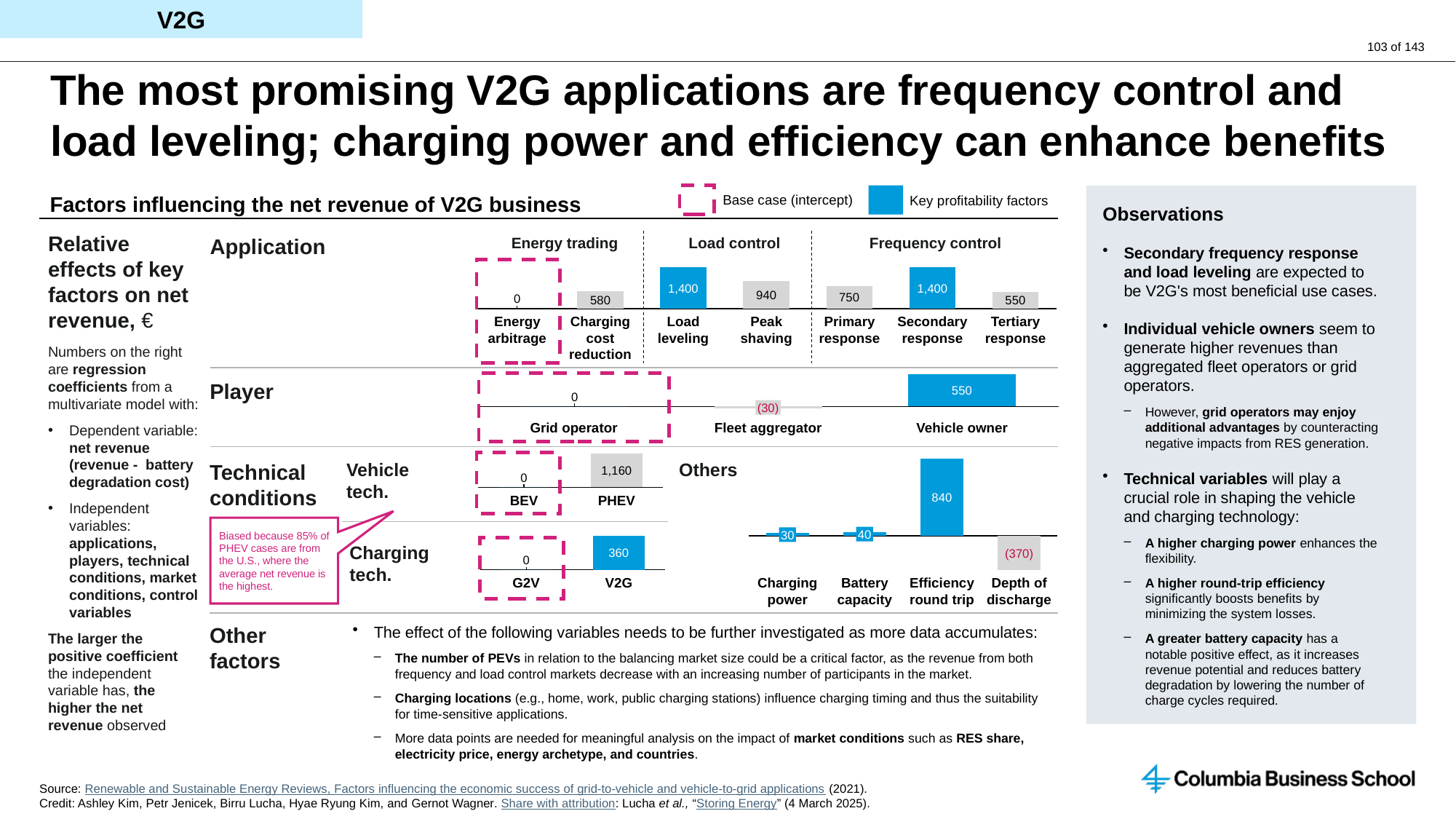
In the Player chart, what is the value for Fleet aggregator? (30) In the Application chart, what is the value for Peak shaving? 940 In the Application chart, what is the value for Tertiary response? 550 What kind of chart is used to show the factors influencing the net revenue of V2G business? Bar chart In the Charging tech chart, what is the value for V2G? 360 In the Vehicle tech chart, what is the value for PHEV? 1,160 In the Others chart under Technical conditions, which category has the highest value? Efficiency round trip In the Application chart, which is larger: Primary response or Tertiary response? Primary response How many categories are shown in the Application chart? 7 In the Others chart under Technical conditions, which category has the lowest value? Depth of discharge In the Player chart, which category has the highest value? Vehicle owner In the Application chart, what is the difference between the values for Load leveling and Peak shaving? 460